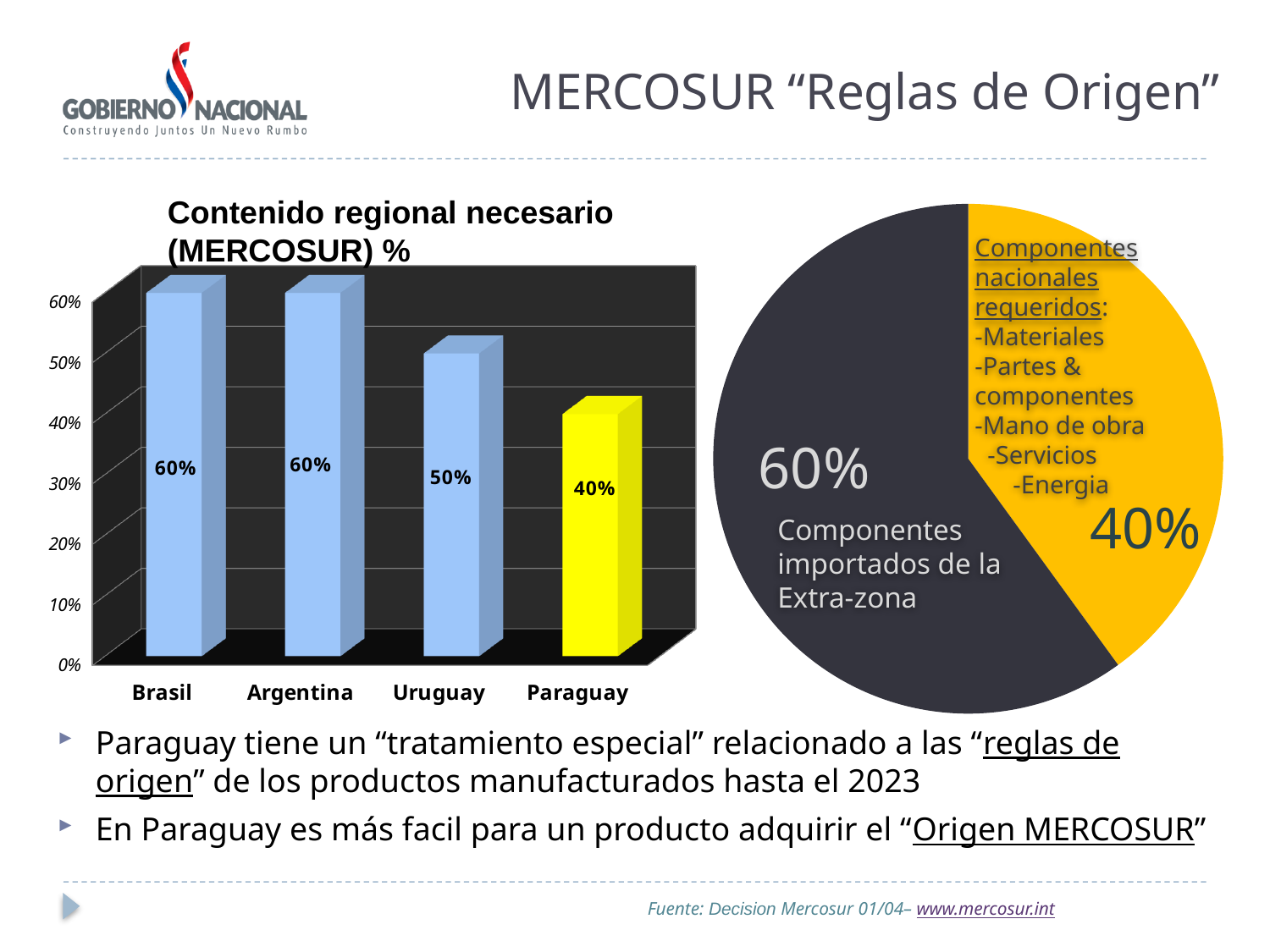
In the bar chart 'Contenido regional necesario (MERCOSUR) %', what colour is the bar for Paraguay? Yellow In the bar chart 'Contenido regional necesario (MERCOSUR) %', which is larger, the value for Uruguay or the value for Paraguay? Uruguay What kind of chart is the chart on the left of the slide? Bar chart In the bar chart 'Contenido regional necesario (MERCOSUR) %', what is the value for Brasil? 60% In the bar chart 'Contenido regional necesario (MERCOSUR) %', how many countries are shown? 4 In the bar chart 'Contenido regional necesario (MERCOSUR) %', what is the value for Paraguay? 40% In the bar chart 'Contenido regional necesario (MERCOSUR) %', what is the difference between the values for Brasil and Paraguay? 20% In the bar chart 'Contenido regional necesario (MERCOSUR) %', do the values rise or fall from Brasil to Paraguay along the x axis? Fall In the bar chart 'Contenido regional necesario (MERCOSUR) %', what is the value for Uruguay? 50% In the bar chart 'Contenido regional necesario (MERCOSUR) %', which country has the lowest value? Paraguay In the pie chart on the right, what share is labelled 'Componentes nacionales requeridos'? 40% In the pie chart on the right, what share is labelled 'Componentes importados de la Extra-zona'? 60%